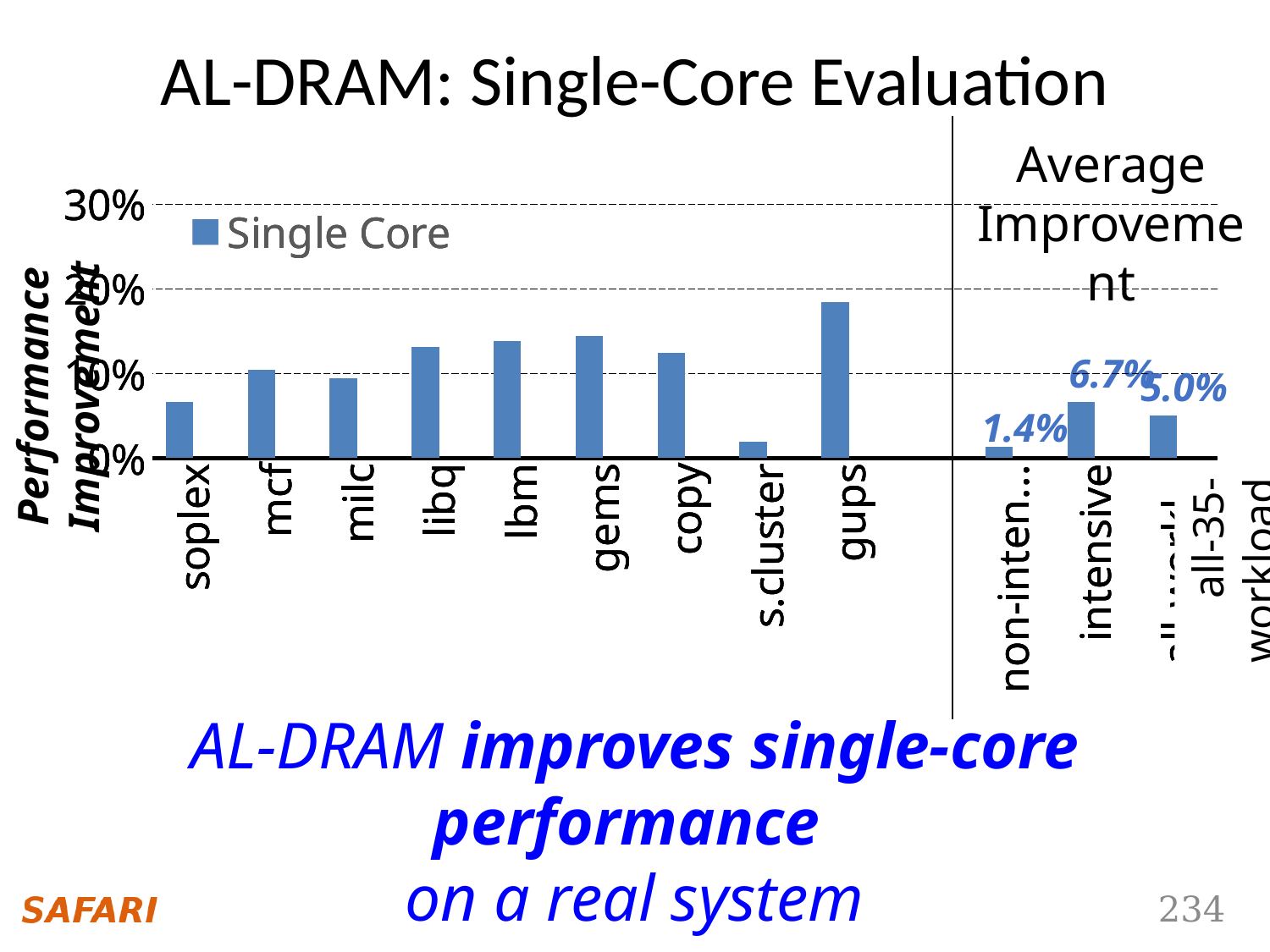
Is the value for s.cluster greater or less than 10%? less Which category has the highest bar in the chart? gups What is the difference between the intensive value and the non-intensive value? 5.3% Among the nine individual benchmarks to the left of the vertical divider, which has the lowest bar? s.cluster How many series does the legend list? 1 Is the value for gups greater or less than 10%? greater What is the value shown for the non-intensive category? 1.4% How many categories are shown on the x axis? 12 Which is larger, the value for gups or the value for soplex? gups What is the value shown for the all-35-workload category? 5.0% What is the value shown for the intensive category? 6.7% What kind of chart is shown on the slide? bar chart